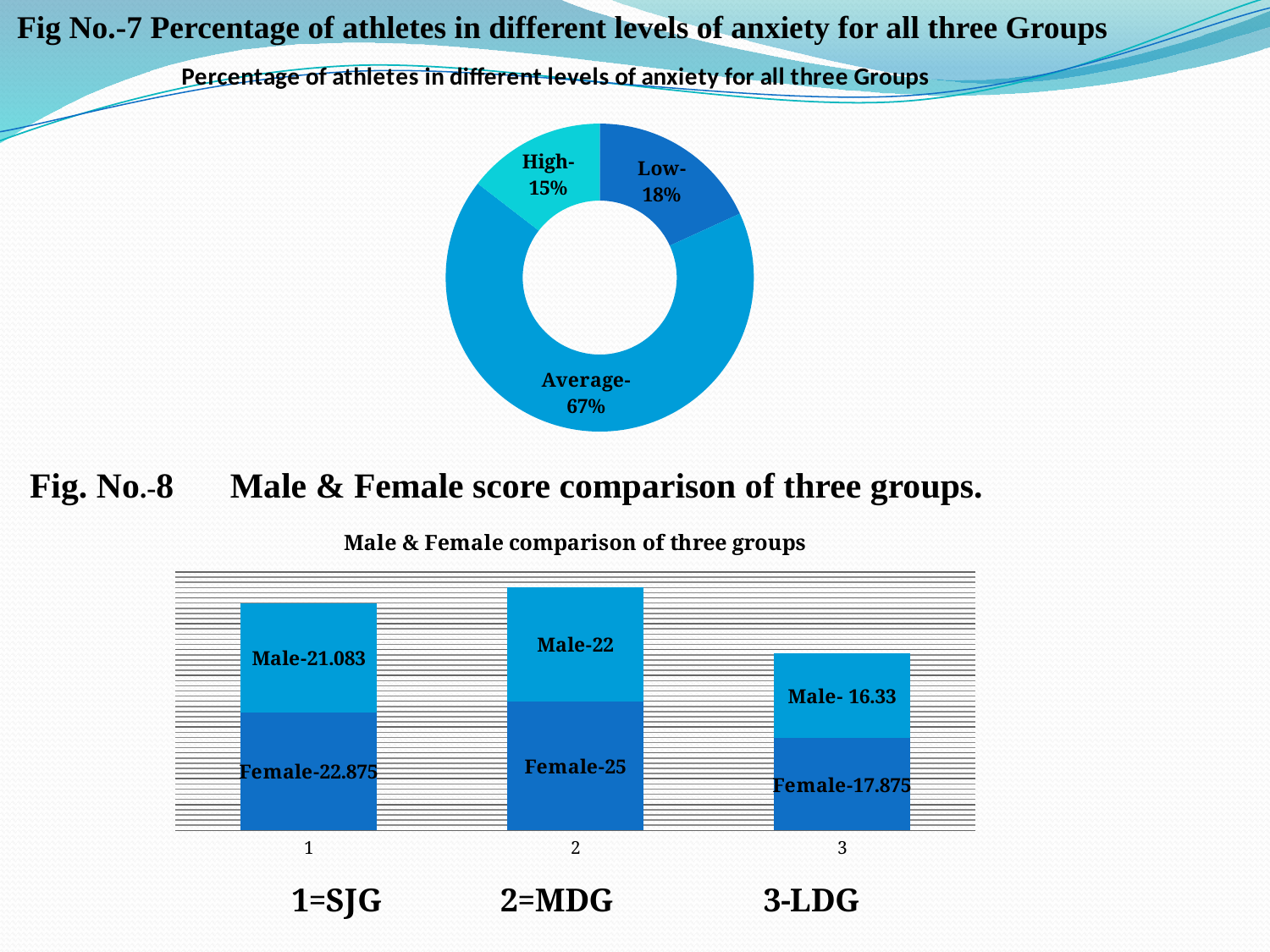
In the bar chart 'Male & Female comparison of three groups', which group has the highest Female score? 2 (MDG) How many anxiety levels are shown in the doughnut chart at the top of the slide? 3 In the doughnut chart 'Percentage of athletes in different levels of anxiety for all three Groups', what percentage of athletes are in the Average level? 67% In the doughnut chart at the top of the slide, how many percentage points larger is the Low share than the High share? 3% In the bar chart 'Male & Female comparison of three groups', what is the Female score for group 3 (LDG)? 17.875 In the bar chart 'Male & Female comparison of three groups', which is larger for group 1 (SJG): the Male score or the Female score? Female In the doughnut chart at the top of the slide, which anxiety level has the smallest share of athletes? High In the doughnut chart at the top of the slide, which anxiety level has the largest share of athletes? Average In the bar chart 'Male & Female comparison of three groups', what is the combined Male and Female total for group 2 (MDG)? 47 What kind of chart is the bottom chart on the slide? Stacked bar chart In the bar chart 'Male & Female comparison of three groups', what is the Male score for group 2 (MDG)? 22 What kind of chart is the top chart on the slide? Doughnut (pie) chart